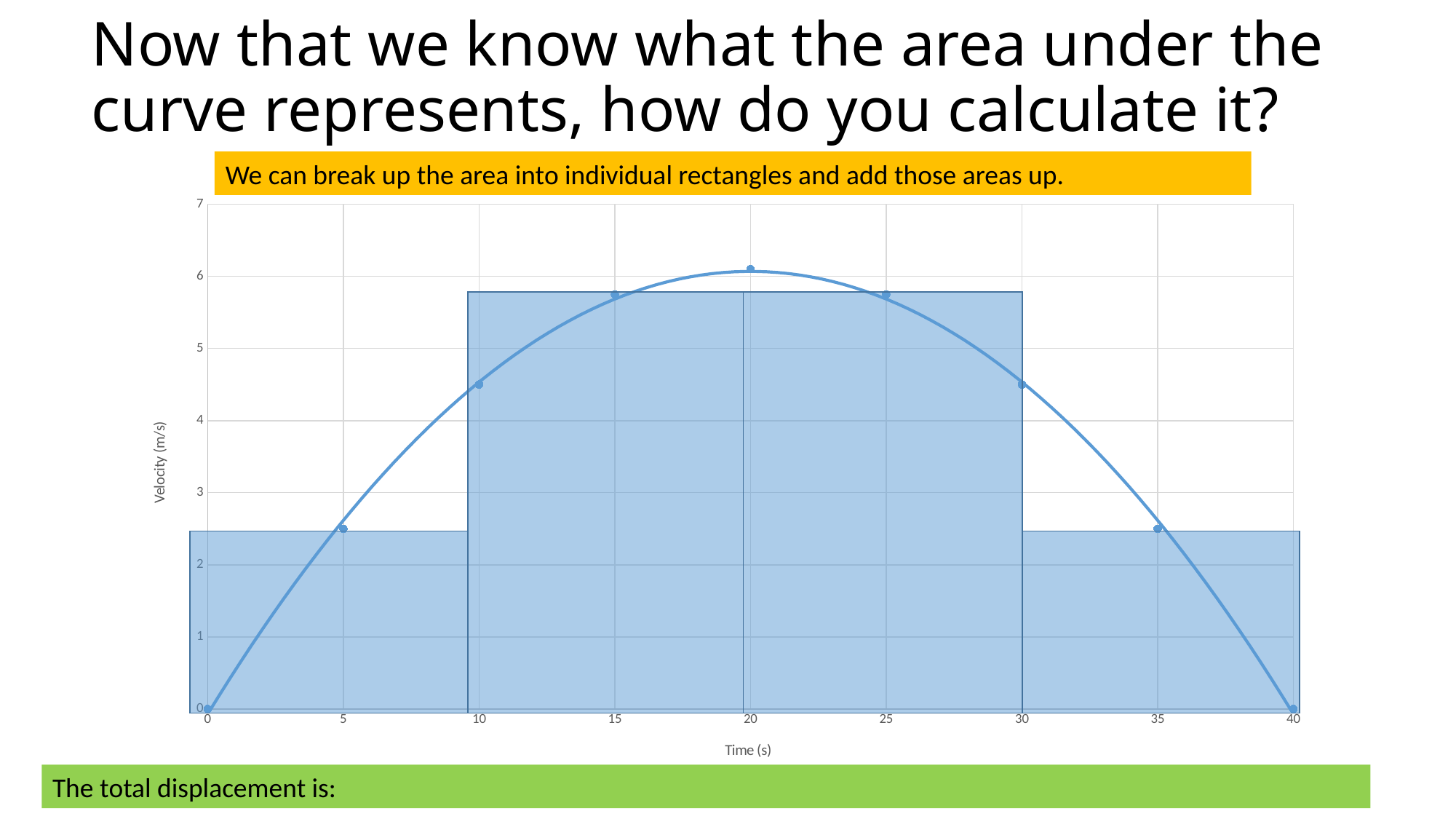
Is the velocity at time 15 s greater or less than 5? greater Which is larger, the velocity at 10 s or the velocity at 5 s? 10 s What kind of chart is shown on the slide? line chart How does the velocity change as time increases from 0 s to 40 s? rises then falls What is the label of the vertical axis? Velocity (m/s) How many data points are plotted on the curve? 9 What is the velocity at time 0 s? 0 Is the velocity at time 35 s greater or less than 3? less What is the label of the horizontal axis? Time (s) Is the velocity at time 10 s greater or less than 4? greater At which time (s) does the velocity reach its highest value? 20 What is the velocity at time 40 s? 0